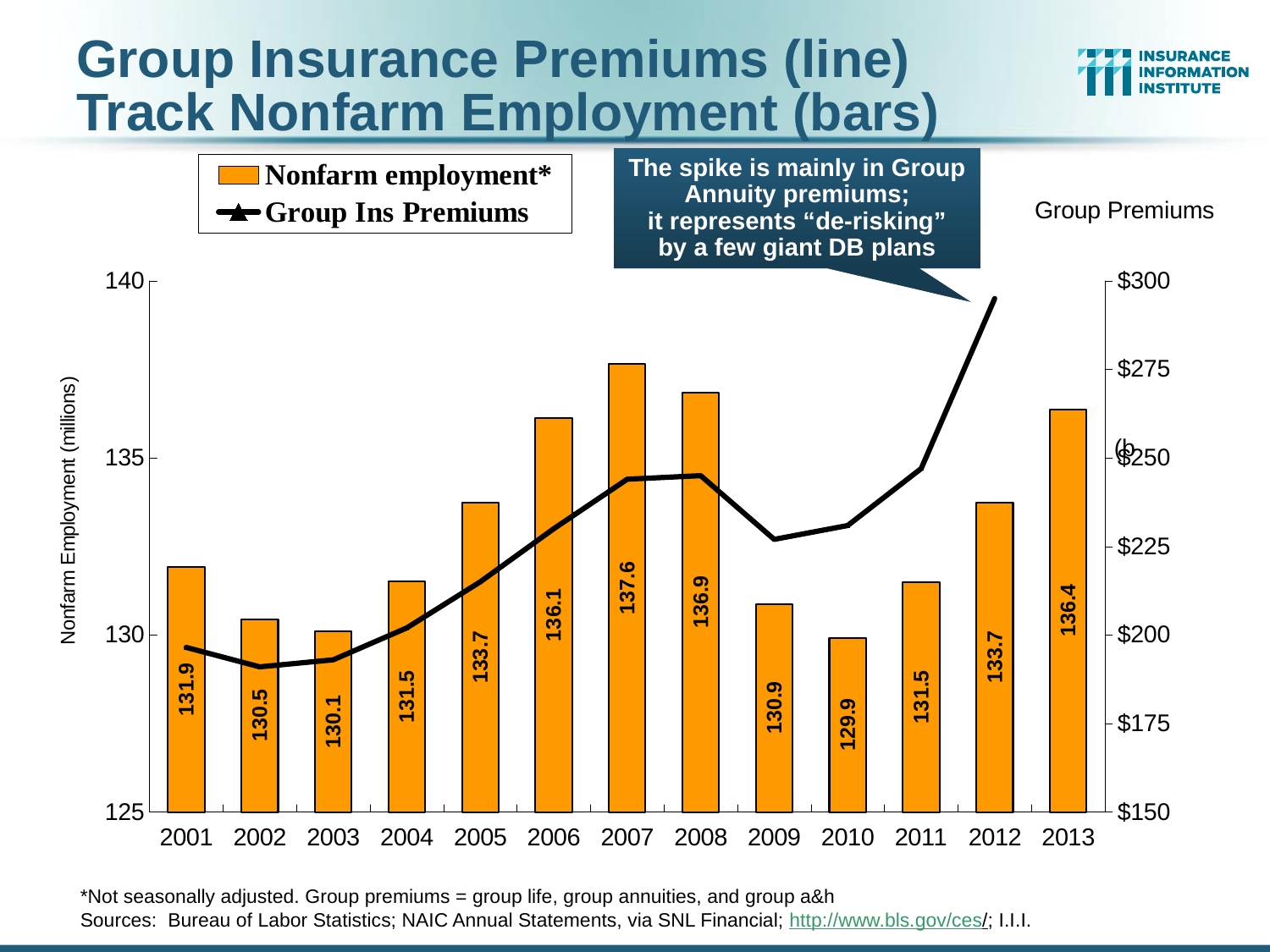
Which year has the highest nonfarm employment bar? 2007 Which year has the lowest nonfarm employment bar? 2010 What is the difference between the nonfarm employment values for 2007 and 2010? 7.7 Is the Group Ins Premiums value for 2012 greater or less than $275? greater How many years are shown on the x axis? 13 What is the difference between the nonfarm employment values for 2013 and 2012? 2.7 What is the nonfarm employment value shown for 2007? 137.6 What is the nonfarm employment value shown for 2013? 136.4 Which year has the larger nonfarm employment value, 2006 or 2008? 2008 Is the Group Ins Premiums value for 2002 greater or less than $200? less How many series does the legend list? 2 What is the nonfarm employment value shown for 2010? 129.9